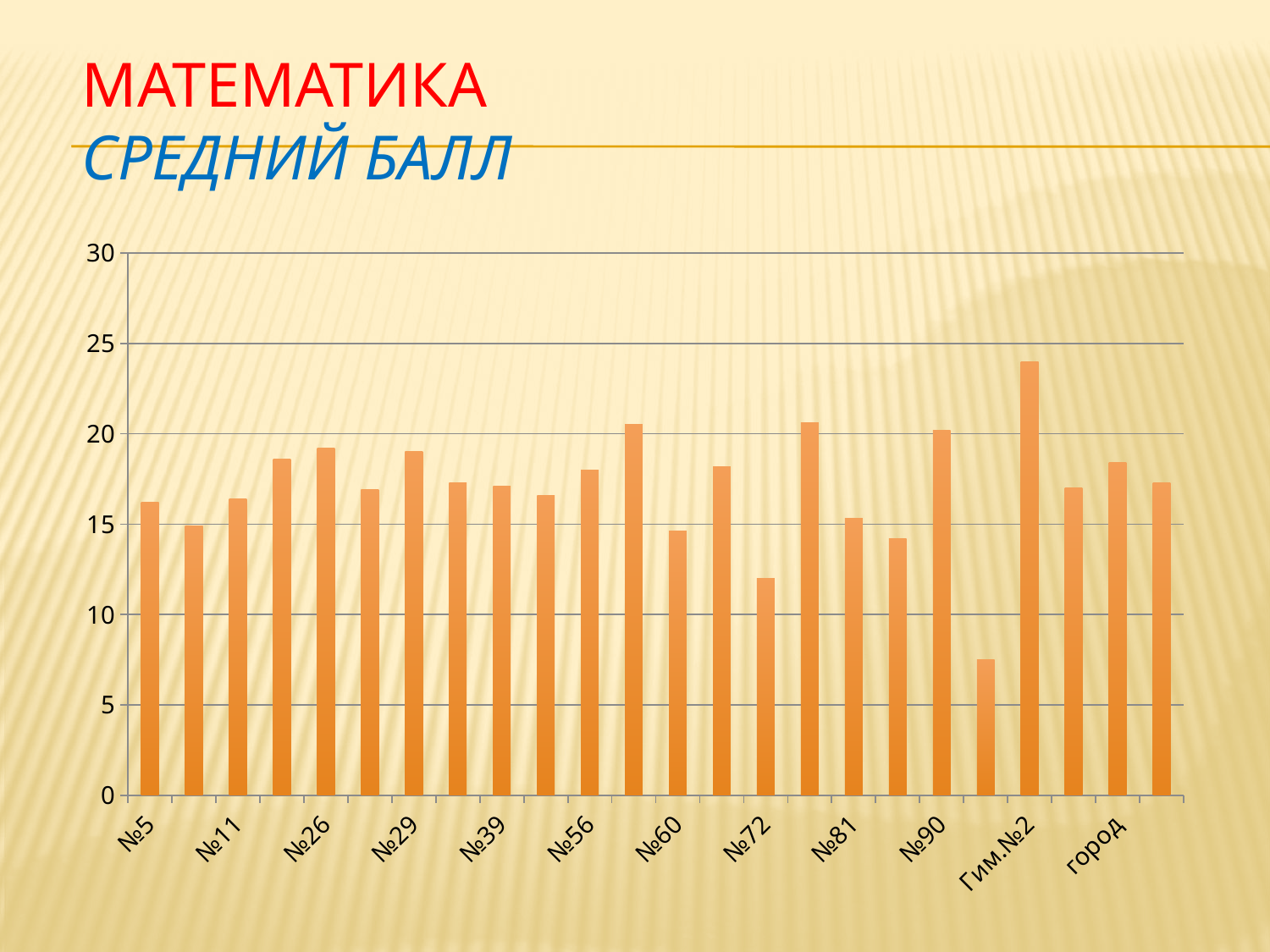
Which labelled category has the highest bar? Гим.№2 What is the maximum value shown on the vertical axis? 30 Is the value for город greater or less than 15? greater Is the value for №5 greater or less than 15? greater What kind of chart is shown on the slide? bar chart Which is larger, the value for №26 or the value for №72? №26 Is the value for №60 greater or less than 15? less What colour are the bars in the chart? orange Which is larger, the value for Гим.№2 or the value for город? Гим.№2